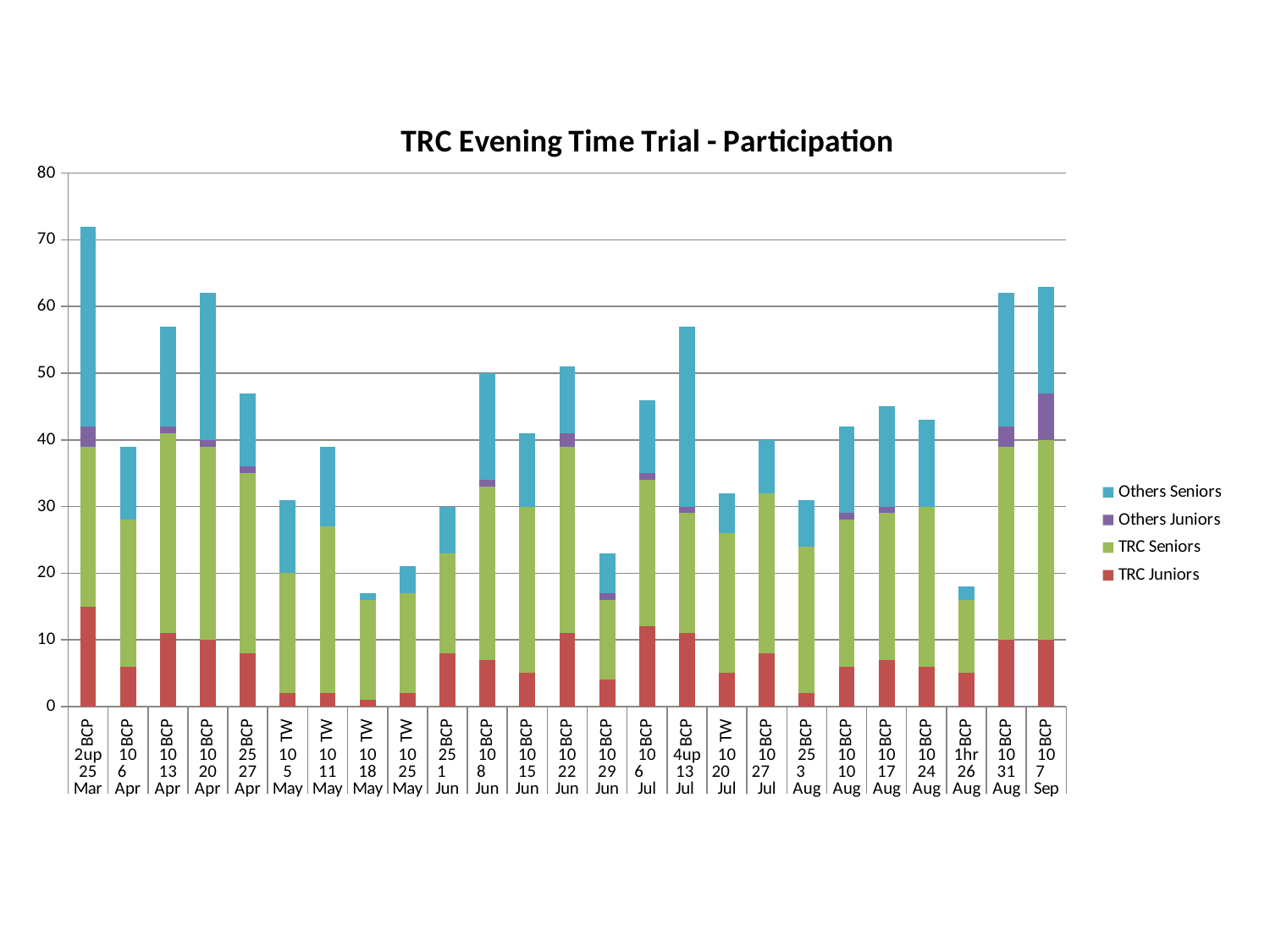
Which colour represents TRC Seniors in the legend? Green Is the total participation for BCP 2up 25 Mar greater or less than 60? greater How many series does the legend list? 4 Is the total participation for TW 10 18 May greater or less than 20? less Which has the larger total participation, BCP 2up 25 Mar or BCP 10 7 Sep? BCP 2up 25 Mar Which has the larger total participation, TW 10 5 May or TW 10 11 May? TW 10 11 May What is the title of the chart? TRC Evening Time Trial - Participation Is the TRC Juniors value for BCP 2up 25 Mar greater or less than 10? greater How many time trial events (bars) are plotted on the chart? 25 What kind of chart is shown on the slide? Stacked bar chart Which event has the highest total participation? BCP 2up 25 Mar